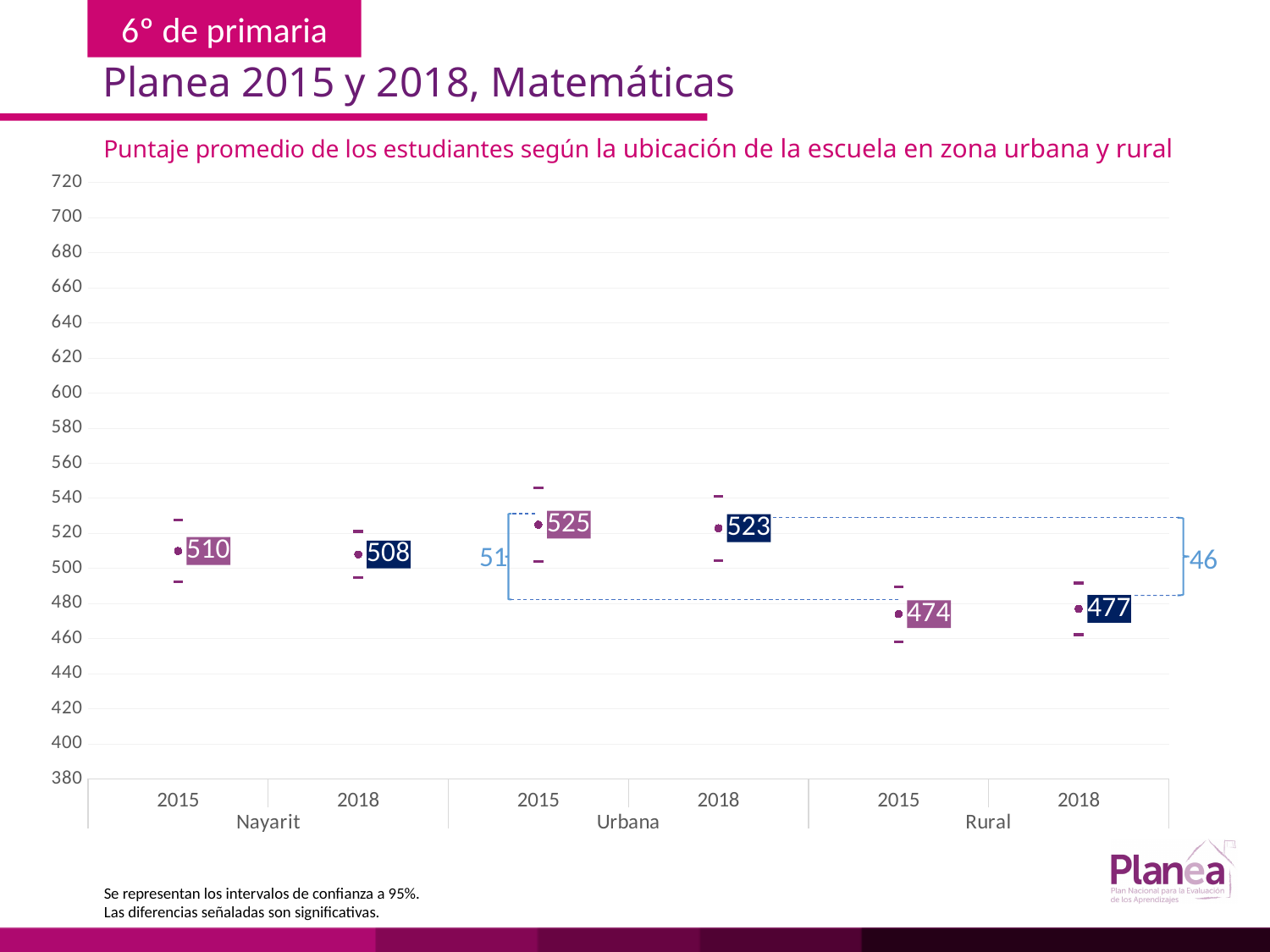
What is the average score for Urbana schools in 2018? 523 What is the title of the chart? Puntaje promedio de los estudiantes según la ubicación de la escuela en zona urbana y rural What is the difference between the Urbana and Rural average scores in 2018? 46 What is the average score for Rural schools in 2015? 474 Which group and year has the lowest average score? Rural 2015 What is the average score for Rural schools in 2018? 477 Which group and year has the highest average score? Urbana 2015 What is the average score for Nayarit in 2015? 510 What is the average score for Nayarit in 2018? 508 What is the average score for Urbana schools in 2015? 525 Which is larger, the Rural score in 2015 or the Rural score in 2018? Rural 2018 How many data points are plotted in the chart? 6